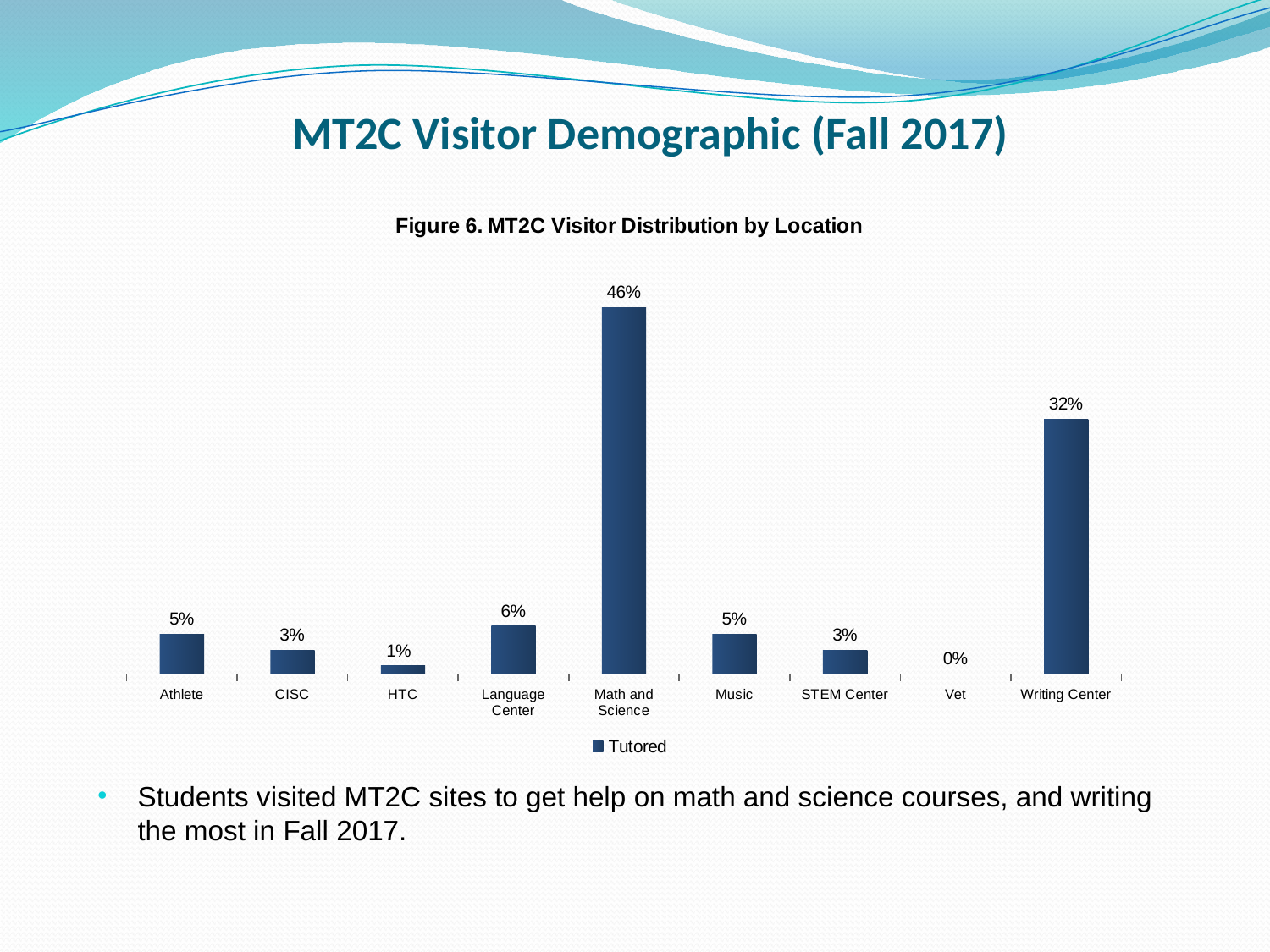
What is the difference between the values for Math and Science and Writing Center? 14% How many series does the legend list? 1 What is the value for Writing Center? 32% What is the value for Math and Science? 46% Which location has the lowest value? Vet What is the value for Language Center? 6% Which location has the highest value? Math and Science What is the title of the chart? Figure 6. MT2C Visitor Distribution by Location Which is larger, the value for Athlete or the value for CISC? Athlete What kind of chart is shown? Bar chart What is the value for Vet? 0% How many locations are shown on the x axis? 9